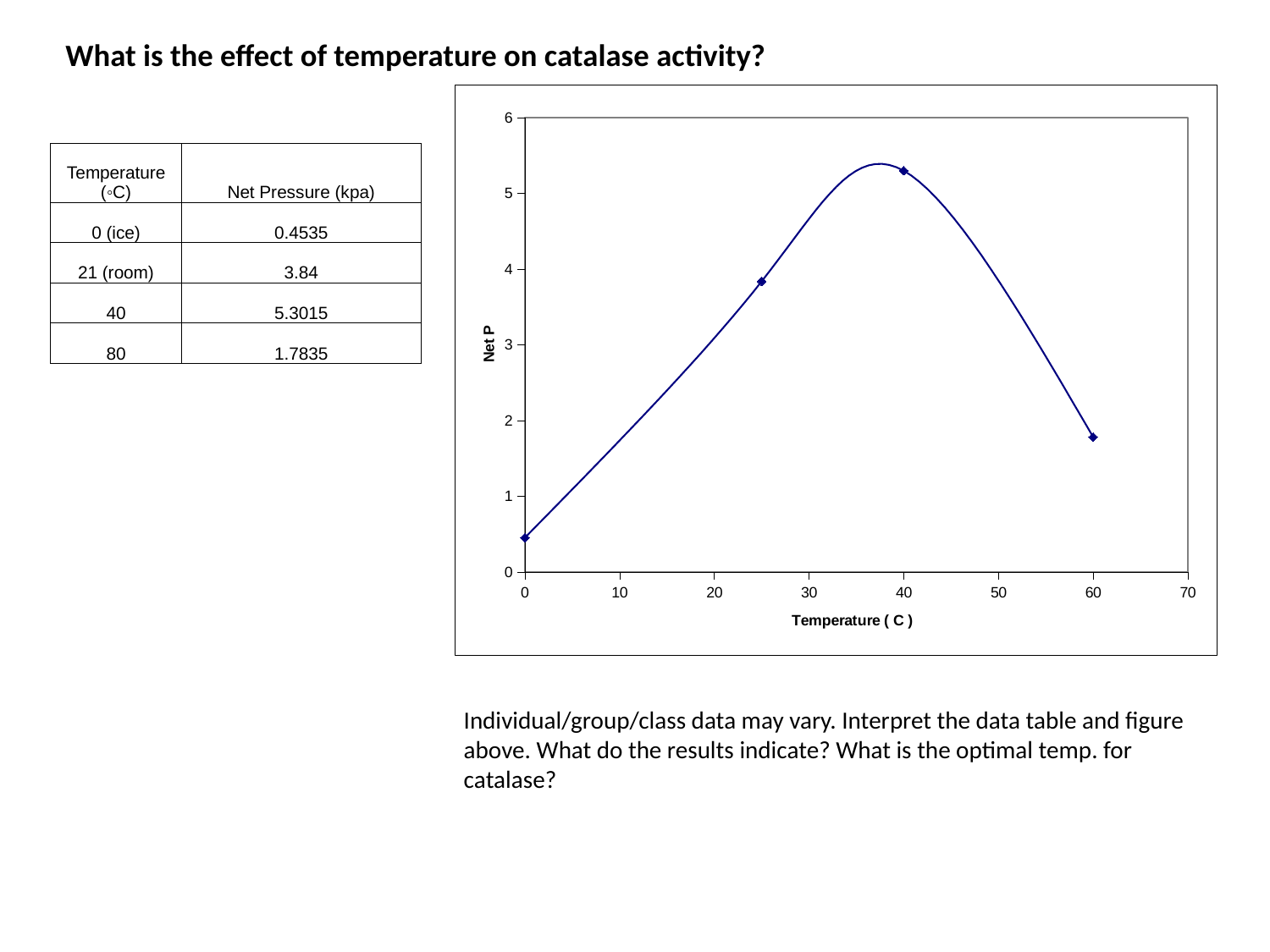
How many data points are plotted on the chart? 4 Is the value plotted at temperature 0 greater or less than 1? less How does the plotted value change as temperature increases from 0 to 70 on the x axis? rises to a peak near 40, then falls Is the value plotted at temperature 60 greater or less than 3? less At which temperature on the x axis does the plotted line reach its highest point? 40 At which temperature on the x axis is the plotted value lowest? 0 What is the label of the chart's y axis? Net P Is the value plotted at temperature 25 greater or less than 3? greater What is the label of the chart's x axis? Temperature ( C ) What kind of chart is shown on the slide? line chart Which is larger, the value plotted at temperature 25 or the value plotted at temperature 60? temperature 25